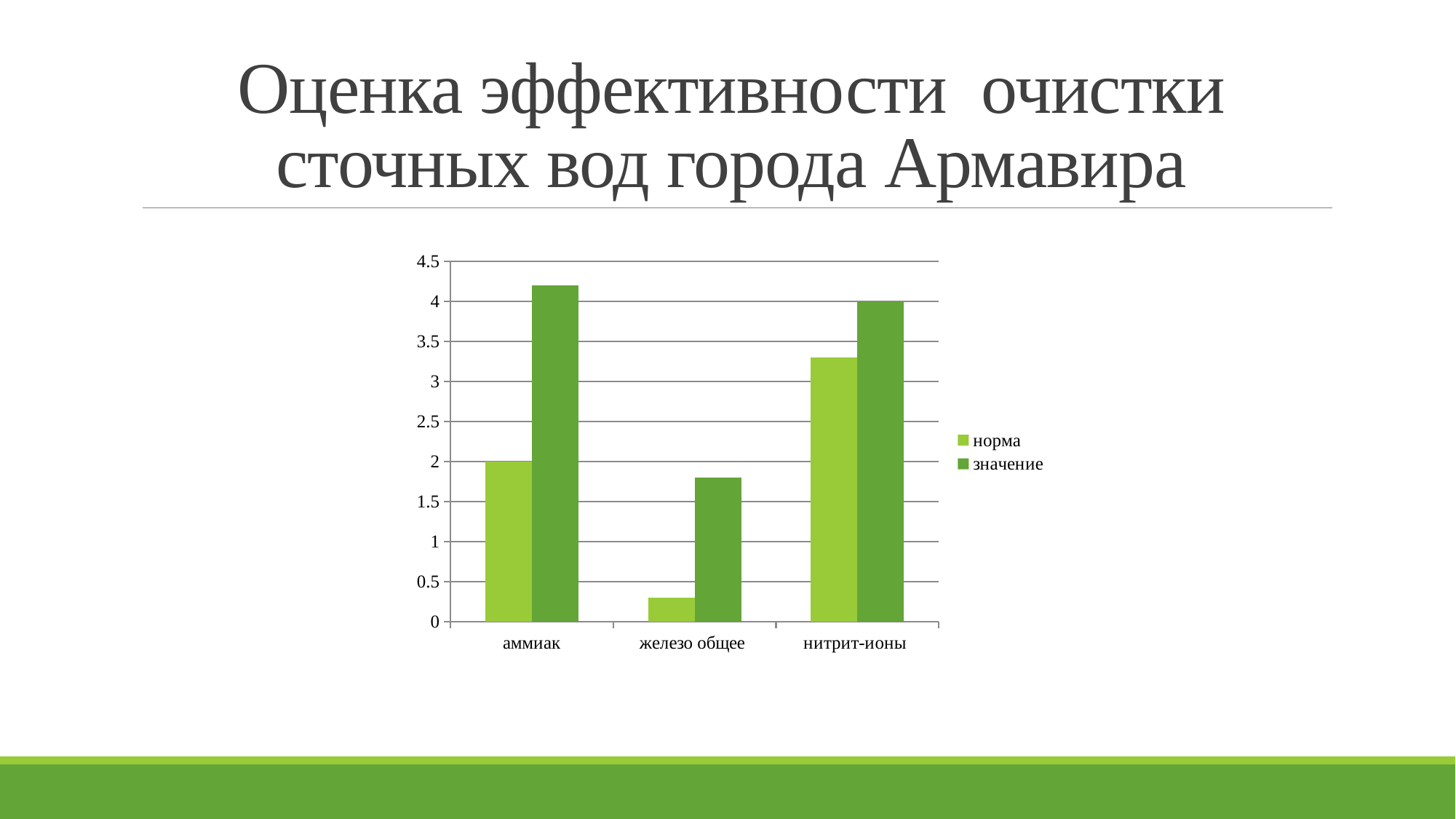
Is the норма bar for железо общее greater or less than 0.5? less Is the значение bar for железо общее greater or less than 2? less Is the значение bar for аммиак greater or less than 4? greater For железо общее, which is larger: the норма bar or the значение bar? значение Which category has the lowest норма value? железо общее What is the value of the значение bar for нитрит-ионы? 4 How many series does the chart legend list? 2 Which category has the highest норма value? нитрит-ионы What is the value of the норма bar for аммиак? 2 What type of chart is shown on the slide? bar chart How many categories are shown on the x axis of the chart? 3